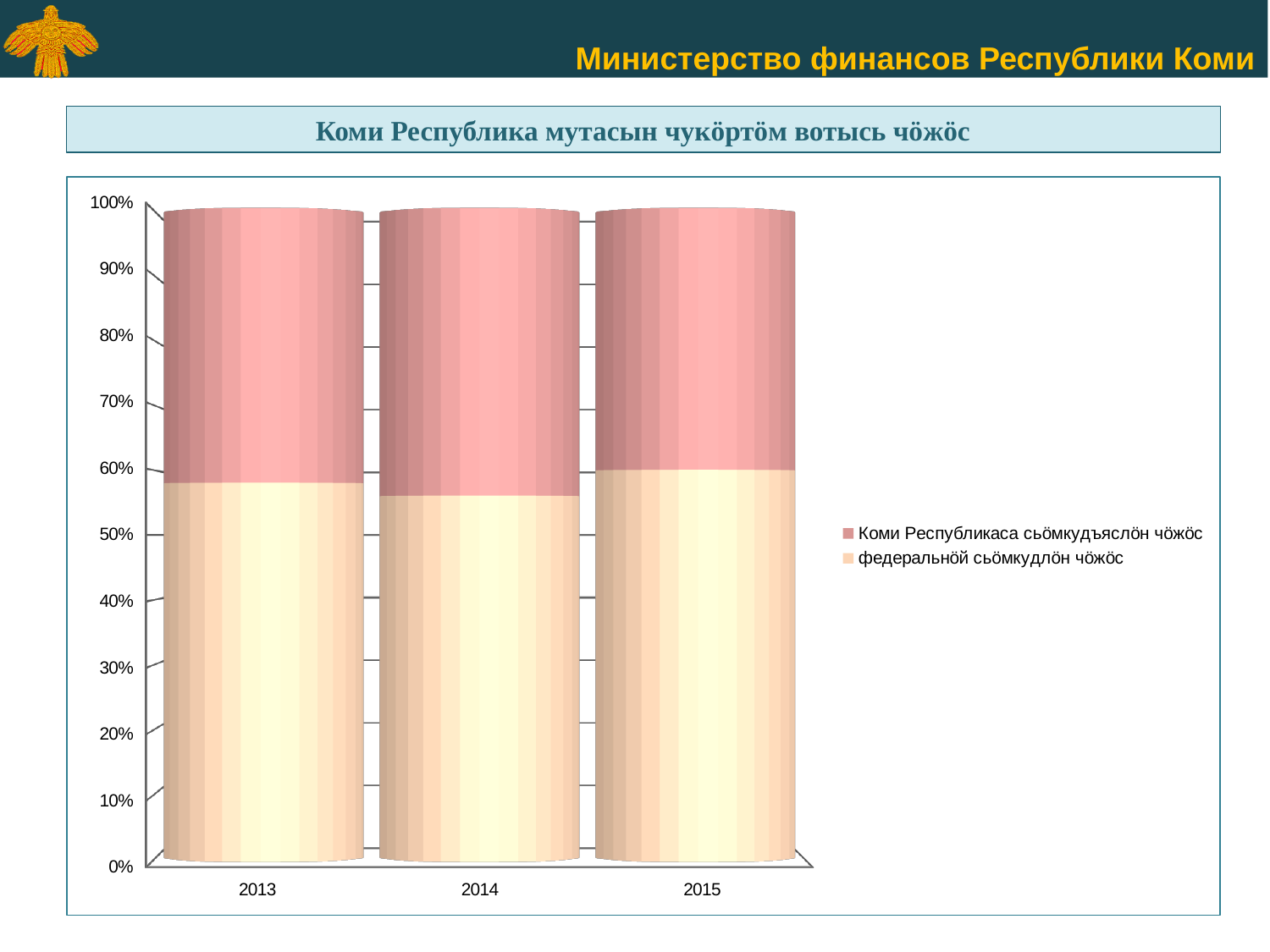
Is the share of федеральнӧй сьӧмкудлӧн чӧжӧс in 2013 greater or less than 50%? greater How many years are shown on the x axis of the chart? 3 What does each stacked bar total on the y axis? 100% What is the title of the chart? Коми Республика мутасын чукӧртӧм вотысь чӧжӧс Which legend entry is shown in pink? Коми Республикаса сьӧмкудъяслӧн чӧжӧс Is the share of Коми Республикаса сьӧмкудъяслӧн чӧжӧс in 2014 greater or less than 40%? greater Which year has the larger share of Коми Республикаса сьӧмкудъяслӧн чӧжӧс, 2014 or 2015? 2014 How many series does the chart legend list? 2 Which year has the larger share of федеральнӧй сьӧмкудлӧн чӧжӧс, 2014 or 2015? 2015 What kind of chart is shown on the slide? Stacked bar chart Is the share of федеральнӧй сьӧмкудлӧн чӧжӧс in 2015 greater or less than 50%? greater